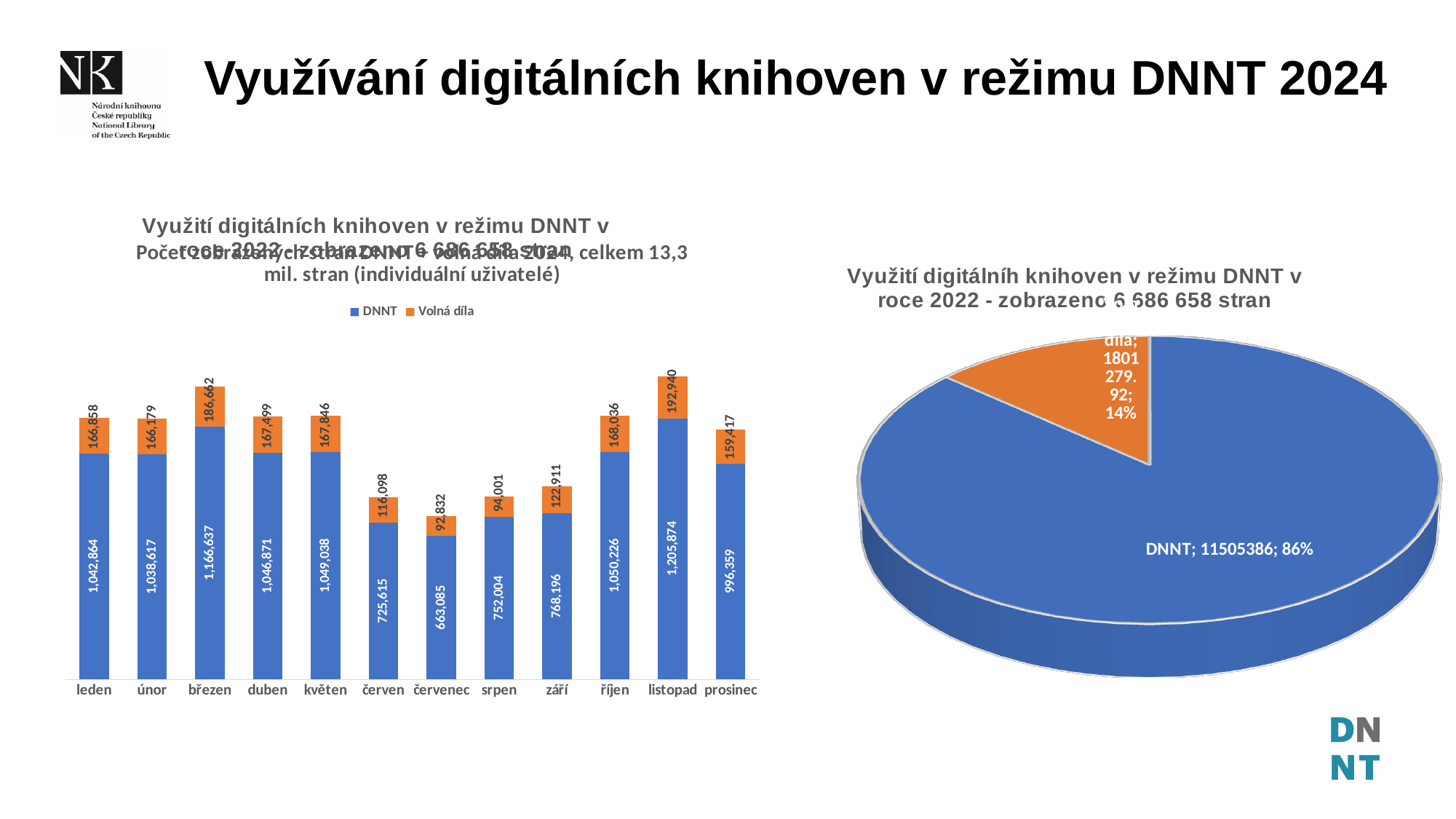
In the bar chart on the left, what is the Volná díla value for březen? 186,662 How many months are shown on the x axis of the bar chart on the left? 12 In the bar chart on the left, which month has the lowest Volná díla value? červenec In the bar chart on the left, what is the total of the stacked bar for listopad? 1,398,814 In the bar chart on the left, which is larger: the DNNT value for září or for srpen? září How many series does the legend of the bar chart on the left list? 2 In the pie chart on the right, what share of the pie does the DNNT slice represent? 86% In the bar chart on the left, what is the difference between the DNNT values for březen and únor? 128,020 What kind of chart is the chart on the right of the slide? pie chart In the bar chart on the left, which month has the lowest DNNT value? červenec In the bar chart on the left, what is the DNNT value for listopad? 1,205,874 In the bar chart on the left, which month has the highest DNNT value? listopad